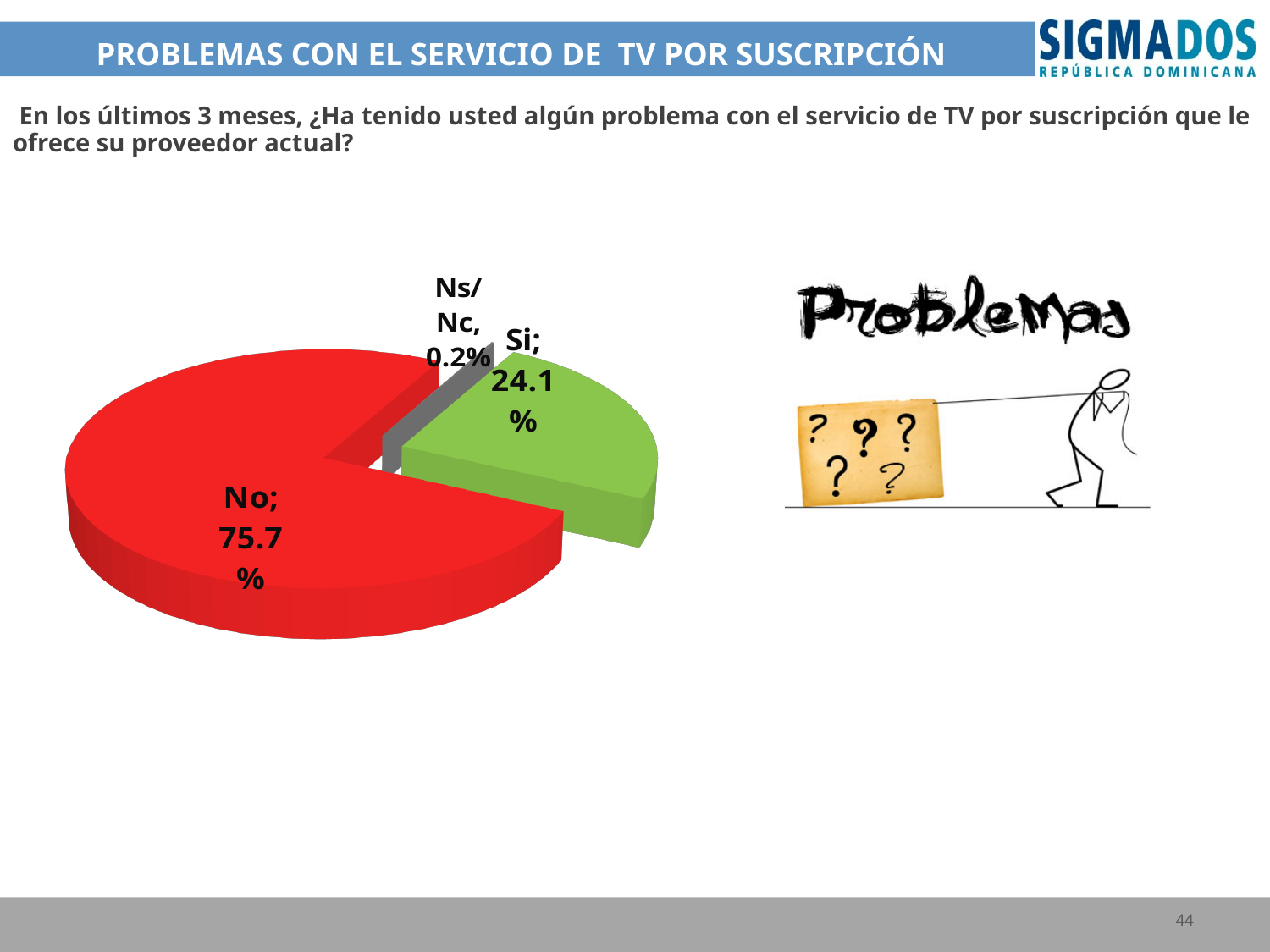
Which is larger, the "Si" slice or the "Ns/Nc" slice? Si What percentage of respondents answered "Si"? 24.1% What is the difference in percentage points between the "No" and "Si" slices? 51.6 What kind of chart is shown on the slide? Pie chart Which response has the largest share of the pie? No What percentage of respondents answered "No"? 75.7% What colour is the "No" slice of the pie? Red Which response has the smallest share of the pie? Ns/Nc How many slices does the pie chart have? 3 What percentage of respondents answered "Ns/Nc"? 0.2% What colour is the "Si" slice of the pie? Green